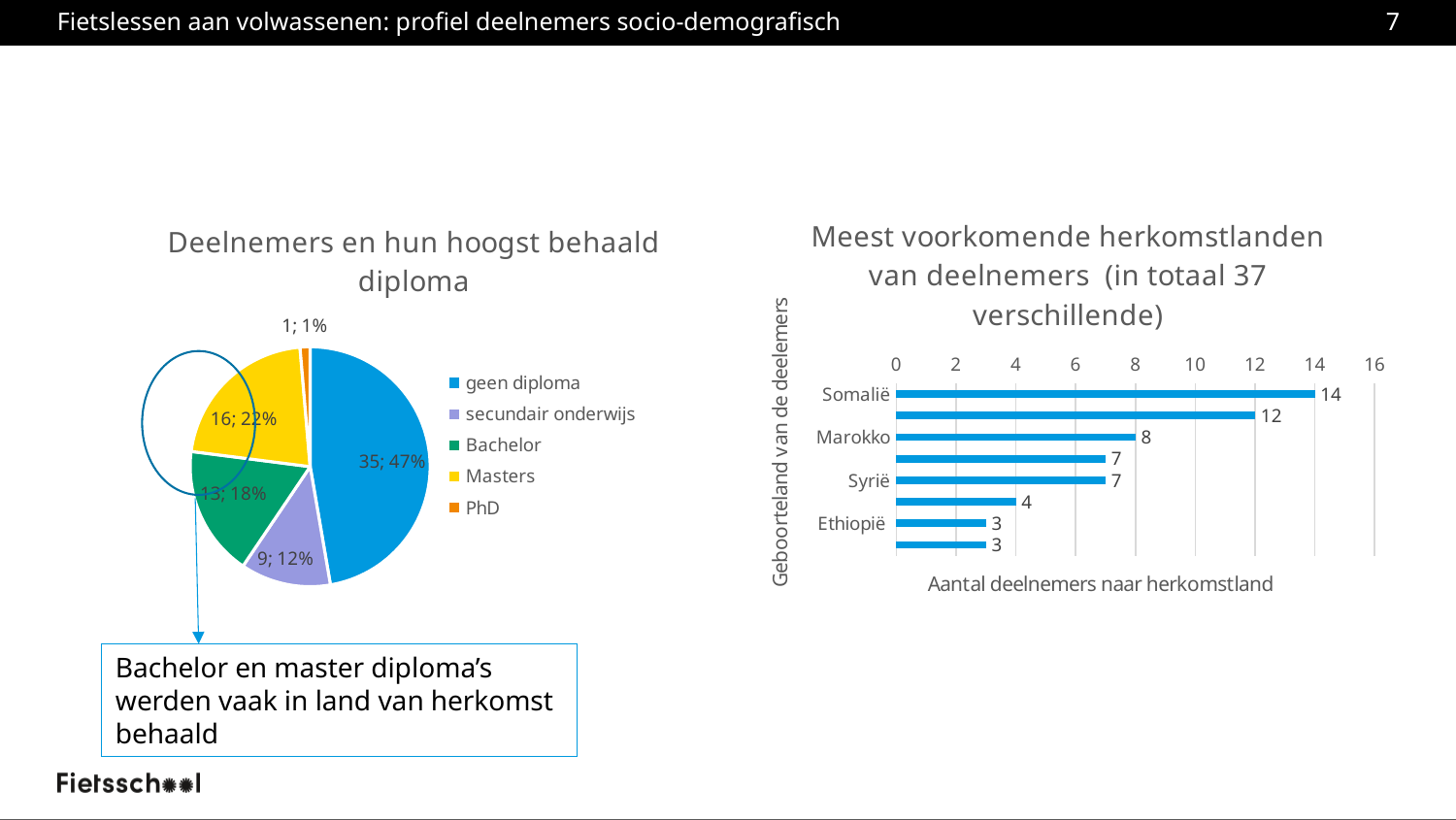
In the pie chart 'Deelnemers en hun hoogst behaald diploma', what percentage share does 'Masters' have? 22% In the pie chart 'Deelnemers en hun hoogst behaald diploma', what is the data label for 'geen diploma'? 35; 47% In the pie chart 'Deelnemers en hun hoogst behaald diploma', which category has the largest slice? geen diploma In the pie chart 'Deelnemers en hun hoogst behaald diploma', how many participants have a Bachelor as highest diploma? 13 In the bar chart 'Meest voorkomende herkomstlanden van deelnemers', what is the value for Marokko? 8 How many categories does the legend of the pie chart 'Deelnemers en hun hoogst behaald diploma' list? 5 In the bar chart 'Meest voorkomende herkomstlanden van deelnemers', what is the value for Somalië? 14 In the bar chart 'Meest voorkomende herkomstlanden van deelnemers', what is the difference between the values for Somalië and Marokko? 6 What kind of chart is 'Deelnemers en hun hoogst behaald diploma'? pie chart What kind of chart is 'Meest voorkomende herkomstlanden van deelnemers'? bar chart In the bar chart 'Meest voorkomende herkomstlanden van deelnemers', which is larger, the value for Marokko or the value for Syrië? Marokko In the pie chart 'Deelnemers en hun hoogst behaald diploma', which category has the smallest slice? PhD